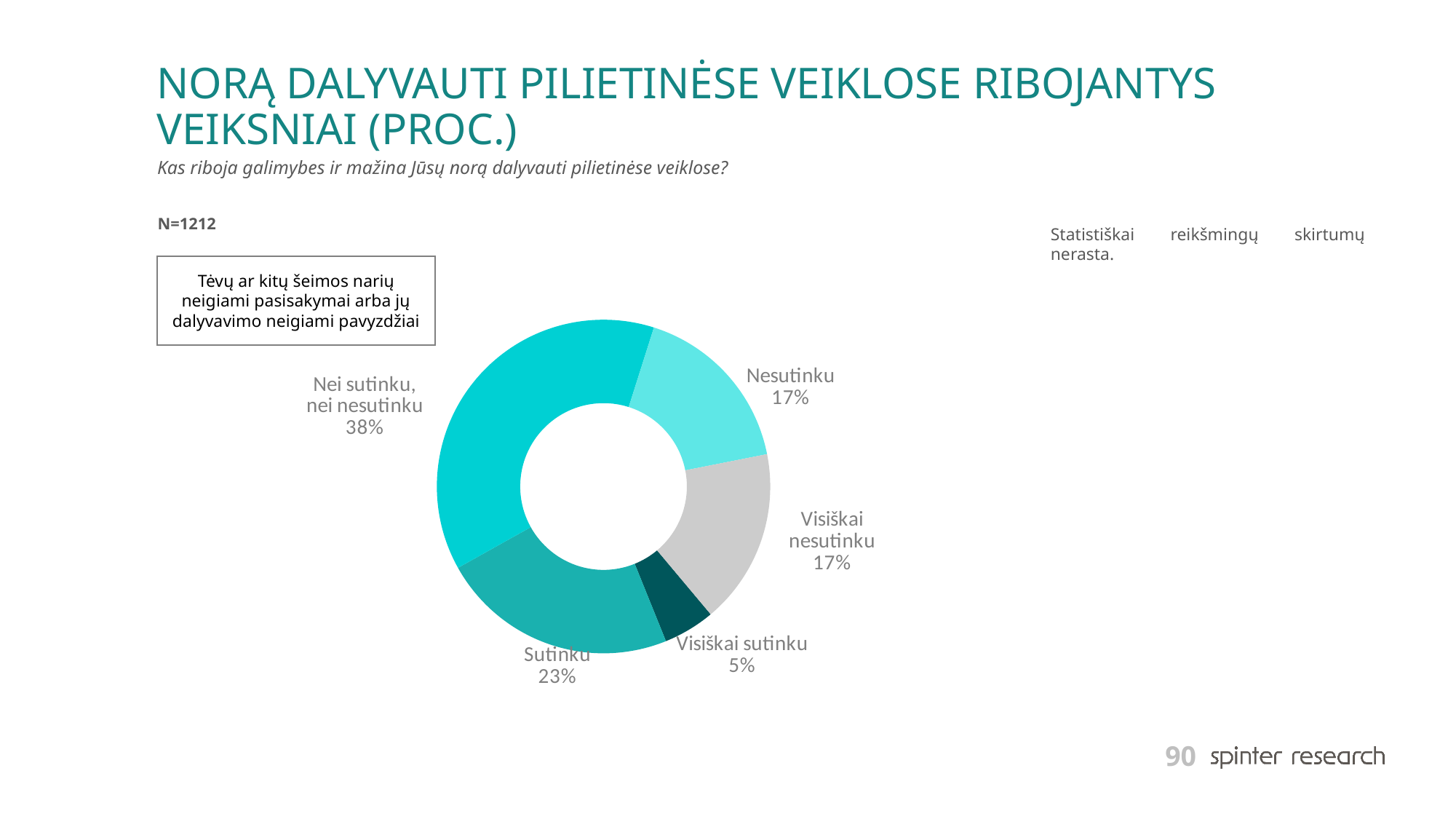
Which category has the smallest share of the chart? Visiškai sutinku What percentage is shown for "Sutinku"? 23% What percentage is shown for "Nei sutinku, nei nesutinku"? 38% Which category has the largest share of the chart? Nei sutinku, nei nesutinku What percentage is shown for "Visiškai sutinku"? 5% What kind of chart is shown on the slide? Donut (pie) chart What percentage is shown for "Nesutinku"? 17% Which is larger, the share for "Sutinku" or the share for "Nesutinku"? Sutinku How many categories (slices) does the chart have? 5 What is the sample size (N) stated on the slide? N=1212 What is the difference in percentage points between "Nei sutinku, nei nesutinku" and "Sutinku"? 15 What percentage is shown for "Visiškai nesutinku"? 17%